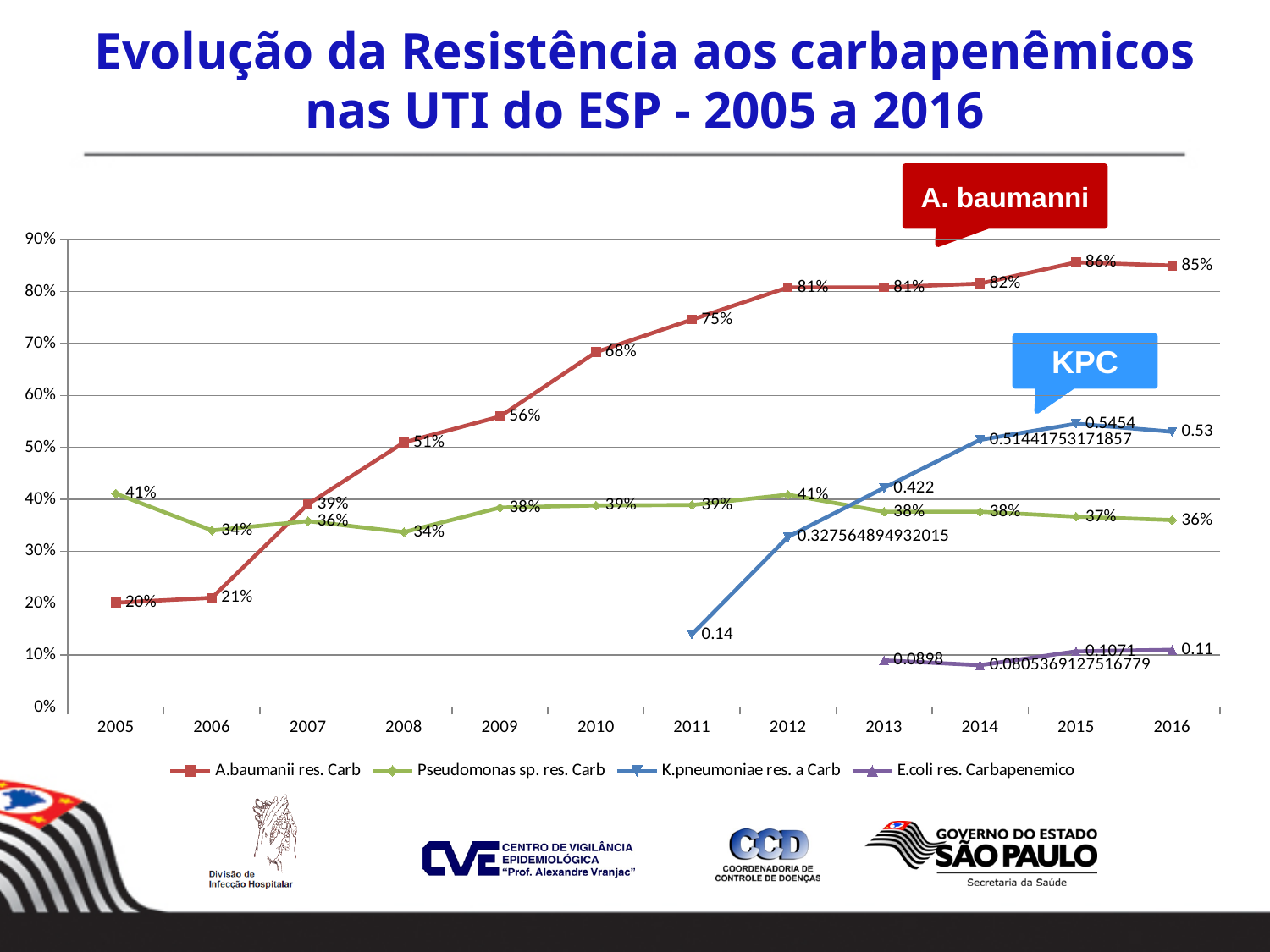
What is the value for K.pneumoniae res. a Carb in 2011? 0.14 What is the value for A.baumanii res. Carb in 2010? 68% In which year is A.baumanii res. Carb at its lowest value? 2005 What is the value for Pseudomonas sp. res. Carb in 2005? 41% What is the difference between the A.baumanii res. Carb values in 2016 and 2005? 65% What kind of chart is shown on the slide? Line chart In which year does A.baumanii res. Carb reach its highest value? 2015 What is the value for E.coli res. Carbapenemico in 2016? 0.11 How many series does the legend list? 4 In 2012, which is larger: A.baumanii res. Carb or Pseudomonas sp. res. Carb? A.baumanii res. Carb Is the value for K.pneumoniae res. a Carb in 2014 greater or less than 50%? greater How many years are shown on the x axis? 12